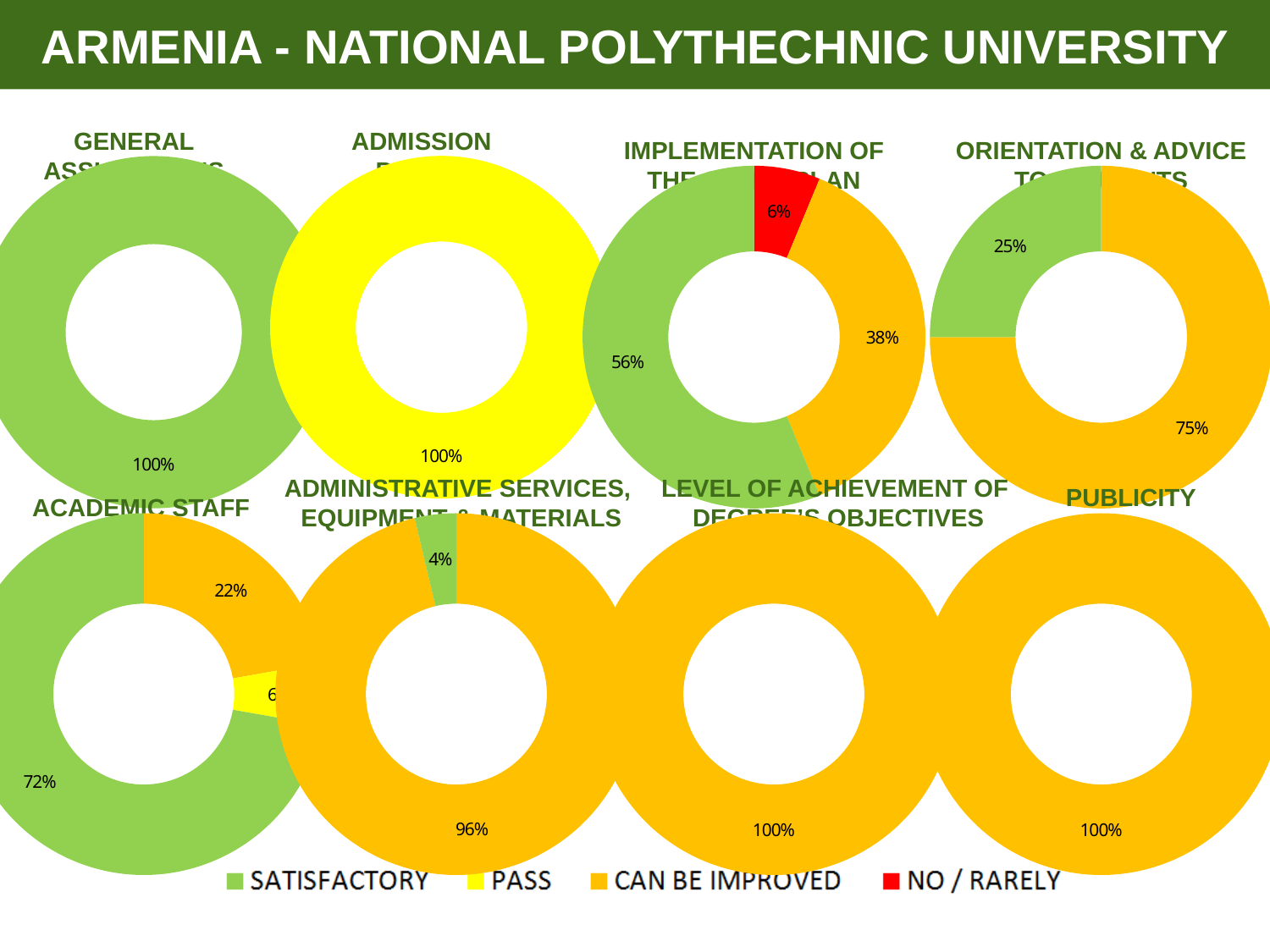
In the 'Academic Staff' chart, what share is labelled for the Can Be Improved (orange) slice? 22% In the 'Publicity' chart, what percentage is shown for the Can Be Improved slice? 100% In the 'Administrative Services, Equipment & Materials' chart, what share is labelled for the Can Be Improved (orange) slice? 96% What type of chart is used for 'Publicity'? Donut (pie) chart In the 'Level of Achievement of Degree's Objectives' chart, what percentage is shown for the Can Be Improved slice? 100% In the third chart of the top row (Implementation of the ... plan), which category has the largest share? Satisfactory How many categories does the legend at the bottom of the slide list? 4 In the 'Administrative Services, Equipment & Materials' chart, what share is labelled for the Satisfactory (green) slice? 4% In the 'Orientation & Advice' chart, what is the difference between the Can Be Improved share and the Satisfactory share? 50% In the third chart of the top row (Implementation of the ... plan), what share is labelled for the No / Rarely (red) slice? 6% In the 'Academic Staff' chart, what share is labelled for the Satisfactory (green) slice? 72% In the 'Orientation & Advice' chart, which is larger: the Satisfactory slice or the Can Be Improved slice? Can Be Improved